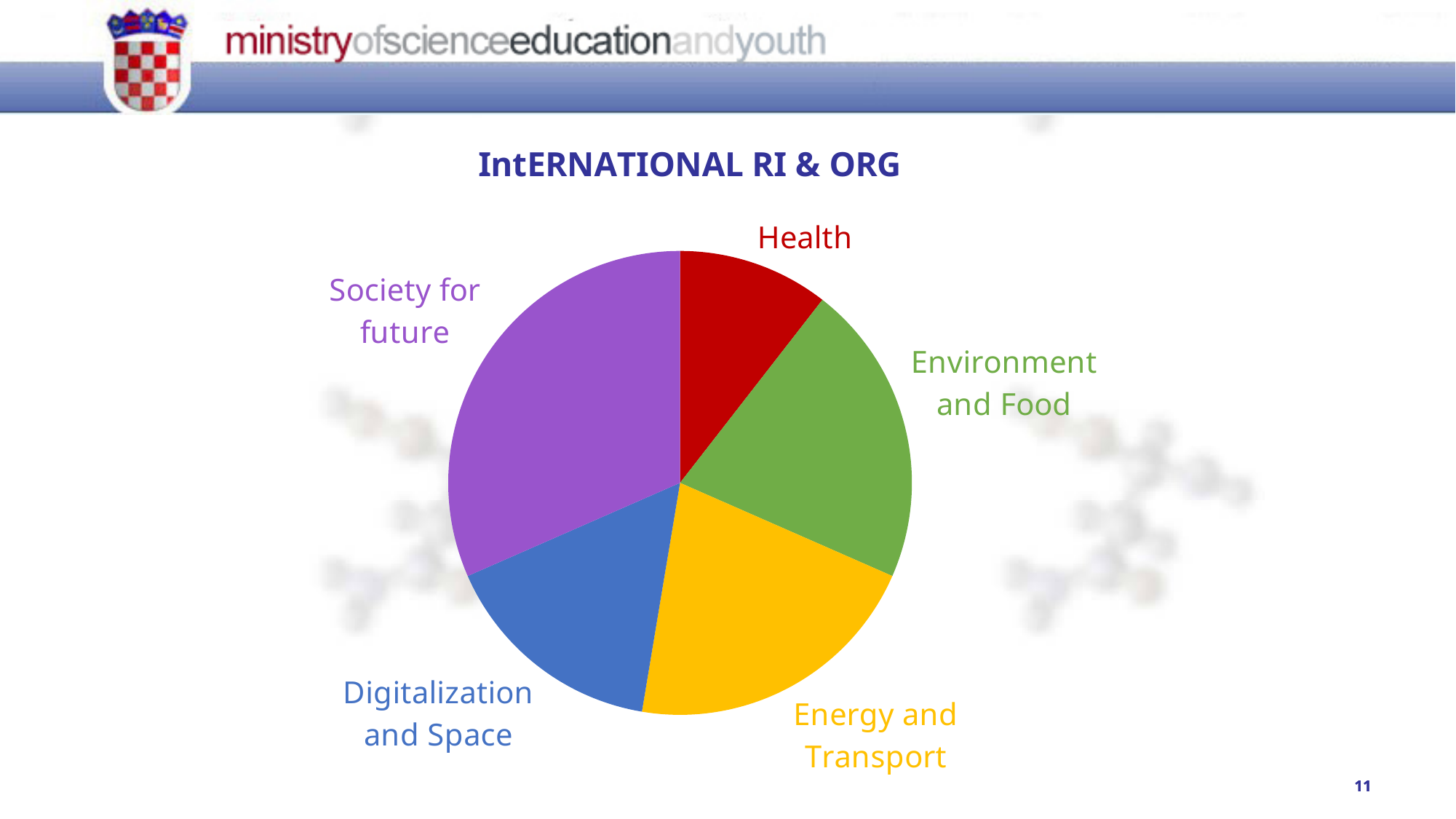
What is the title of the chart? IntERNATIONAL RI & ORG Which slice is larger, Society for future or Energy and Transport? Society for future What kind of chart is shown on the slide? pie chart Which slice is larger, Society for future or Health? Society for future Which slice is larger, Environment and Food or Health? Environment and Food How many slices does the pie chart have? 5 Which category has the smallest slice of the pie chart? Health Which category has the largest slice of the pie chart? Society for future What colour is the Health slice of the pie chart? red